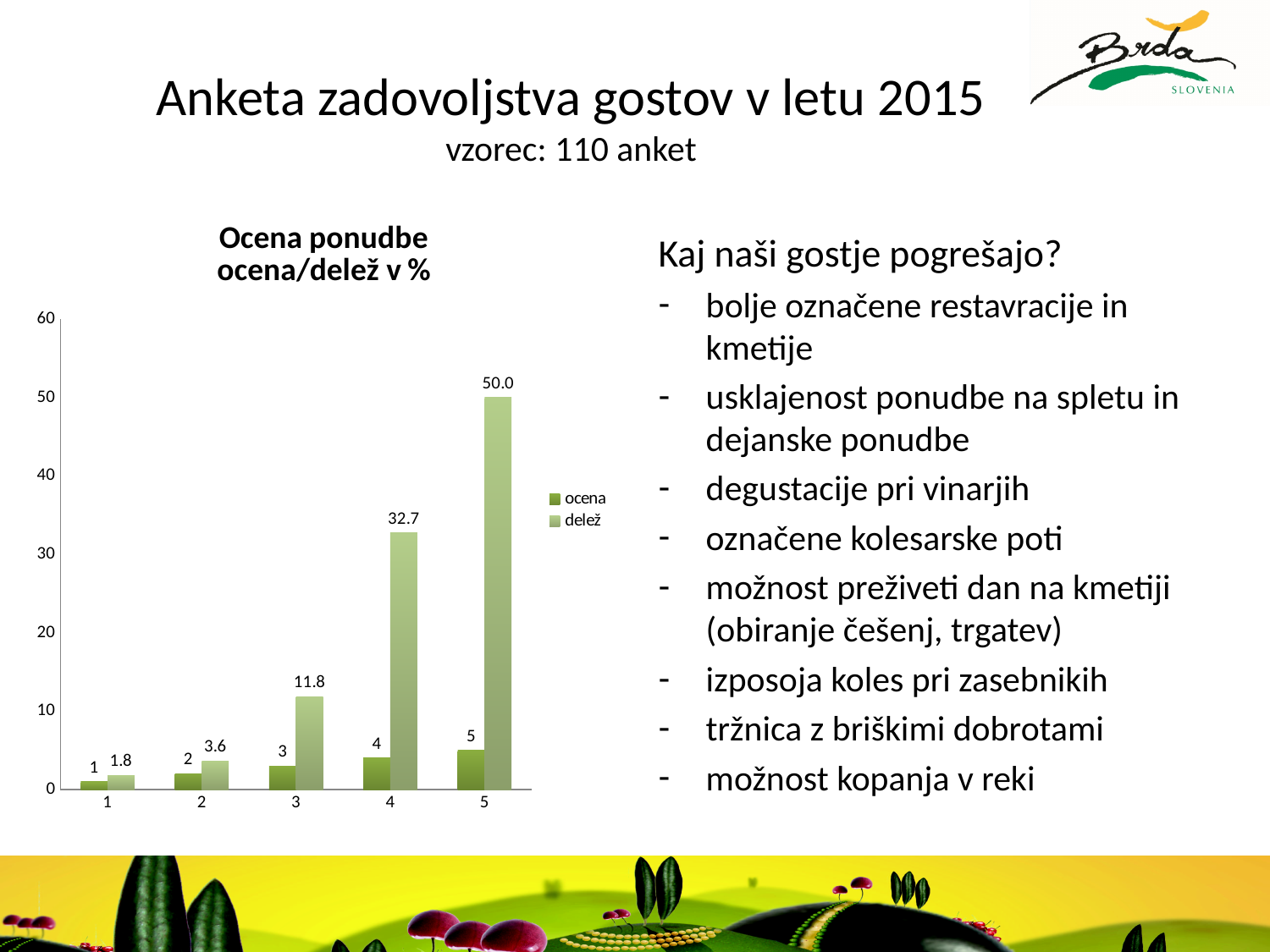
Which is larger, the 'delež' value for category 2 or for category 3? category 3 How many series does the legend list? 2 Which category has the highest 'delež' value? 5 Do the 'delež' values rise or fall from category 1 to category 5? rise What is the difference between the 'delež' values for categories 5 and 4? 17.3 What is the value of the 'ocena' series for category 4? 4 How many categories are shown on the x axis? 5 What is the value of the 'delež' series for category 3? 11.8 What kind of chart is shown on the slide? bar chart What is the value of the 'delež' series for category 5? 50.0 Is the 'delež' value for category 4 greater or less than 30? greater Which category has the lowest 'delež' value? 1